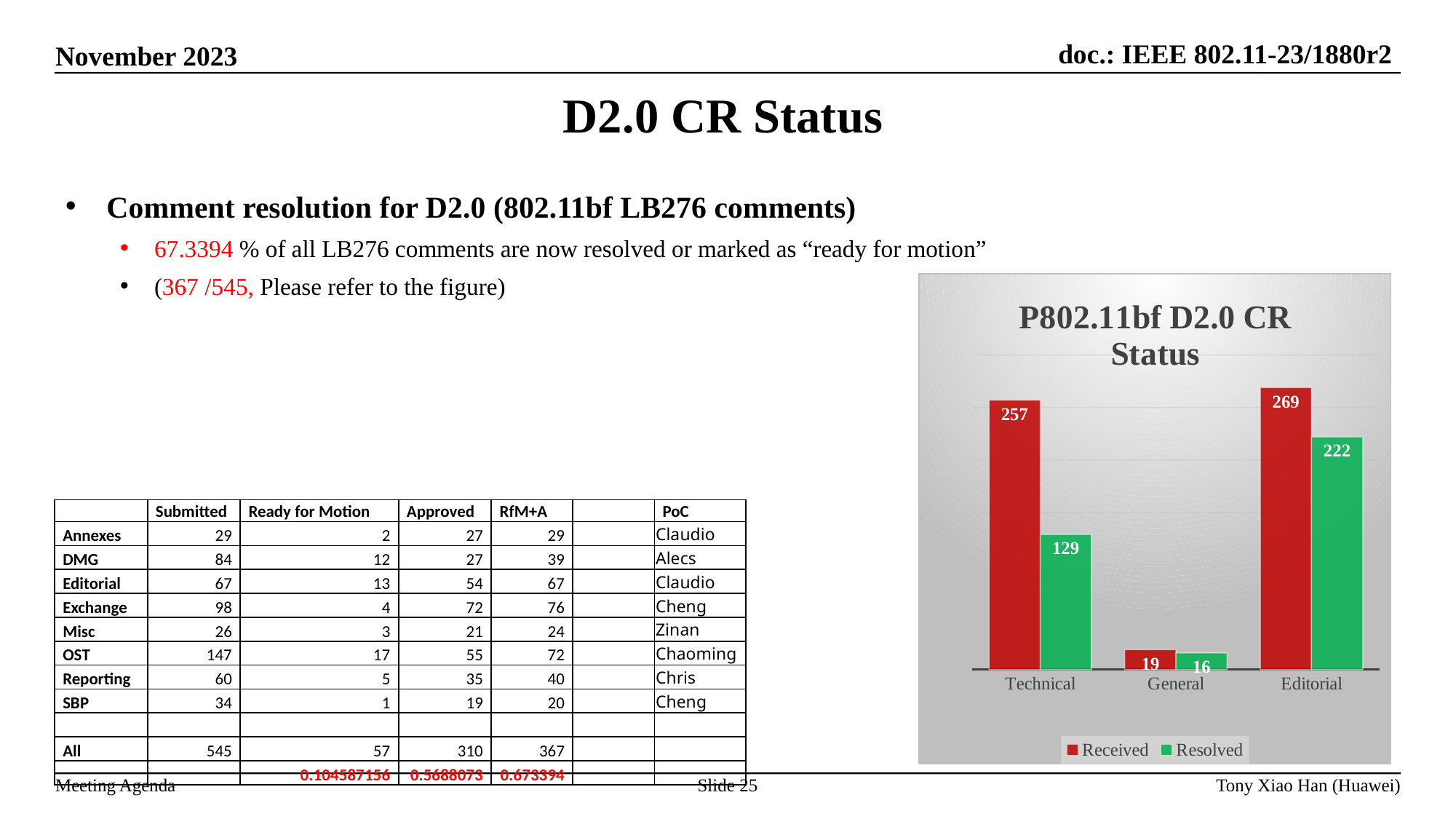
What is the Resolved value for Editorial? 222 What is the Received value for Technical? 257 What is the Resolved value for General? 16 What is the difference between Received and Resolved for Technical? 128 Which category has the highest Received value? Editorial What type of chart is shown on the slide? bar chart How many series does the chart legend list? 2 Is the Resolved value for Technical larger than the Resolved value for Editorial? No How many categories are shown on the x axis of the chart? 3 Which series is shown in green in the chart? Resolved What is the title of the chart? P802.11bf D2.0 CR Status Which category has the lowest Resolved value? General